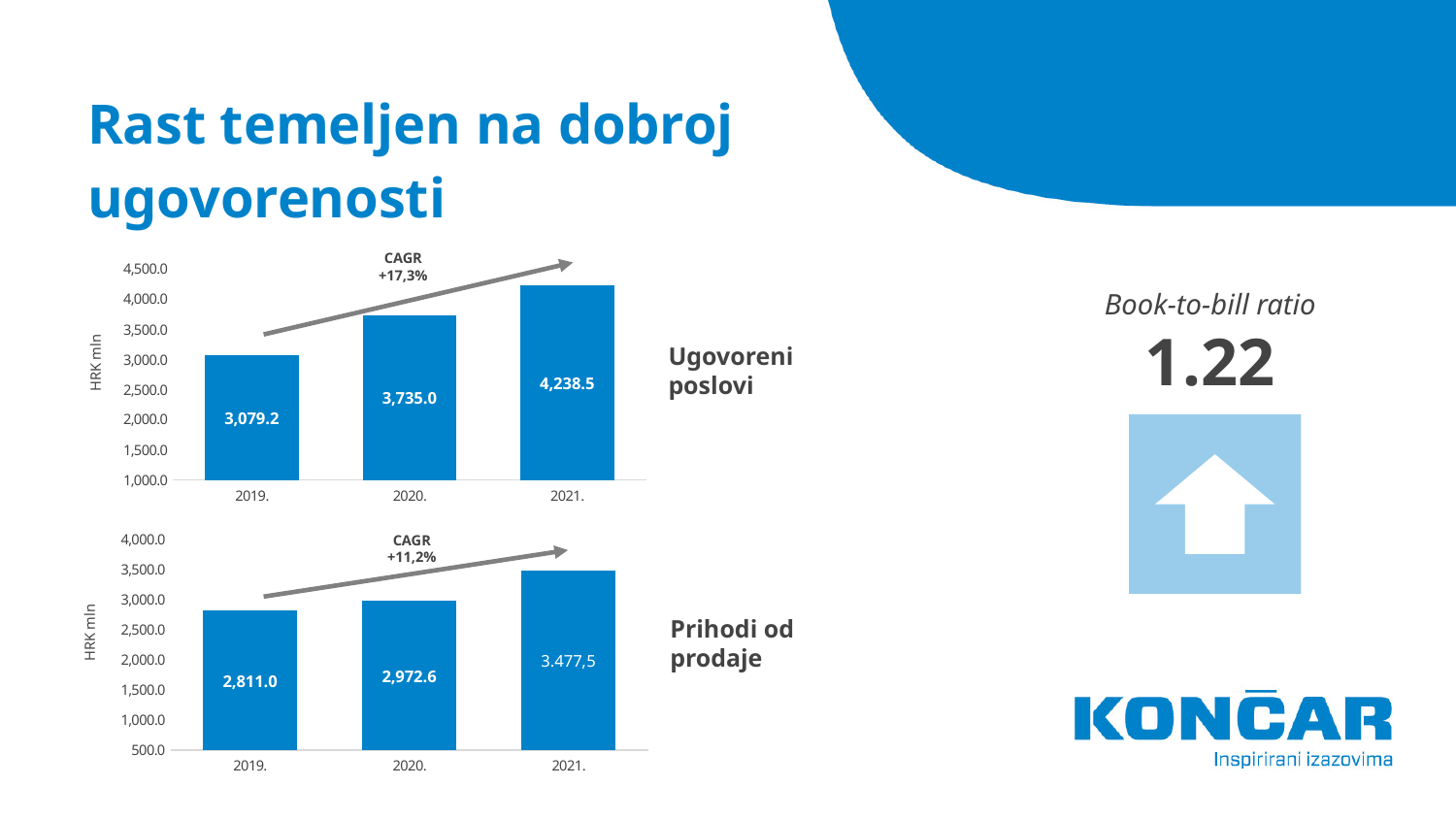
In the Ugovoreni poslovi chart, what is the difference between the 2021. and 2020. values? 503.5 In the Ugovoreni poslovi chart, what is the value for 2021.? 4,238.5 How many years are shown on the x axis of the Ugovoreni poslovi chart? 3 What type of chart is the Prihodi od prodaje chart? Bar chart In the Prihodi od prodaje chart, do the values rise or fall from 2019. to 2021.? Rise In the Prihodi od prodaje chart, which year has the lowest value? 2019. In the Prihodi od prodaje chart, what is the difference between the 2020. and 2019. values? 161.6 Which is larger: the 2020. value in the Ugovoreni poslovi chart or the 2020. value in the Prihodi od prodaje chart? Ugovoreni poslovi In the Prihodi od prodaje chart, what is the value for 2020.? 2,972.6 In the Ugovoreni poslovi chart, what is the value for 2019.? 3,079.2 In the Ugovoreni poslovi chart, which year has the highest value? 2021. In the Prihodi od prodaje chart, what is the value for 2021.? 3.477,5